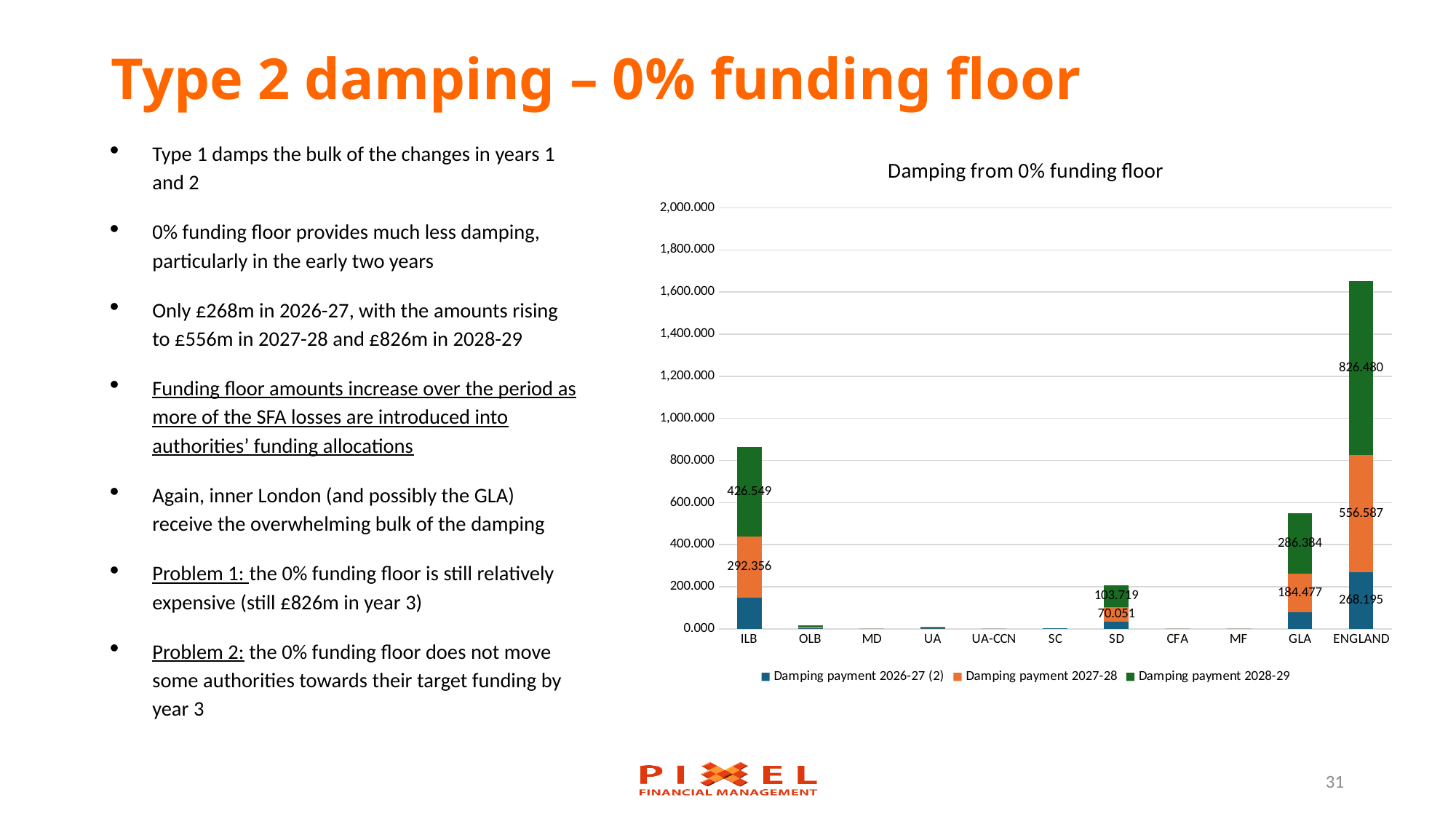
Is the total stacked bar for GLA greater or less than 600.000? less Which has the larger total stacked bar, ILB or GLA? ILB What is the Damping payment 2028-29 value for GLA? 286.384 Which category has the highest total stacked bar? ENGLAND What is the Damping payment 2026-27 (2) value for ENGLAND? 268.195 What is the Damping payment 2027-28 value for ILB? 292.356 How many series does the chart legend list? 3 What is the difference between the Damping payment 2028-29 and Damping payment 2027-28 values for ENGLAND? 269.893 How many categories are shown on the x axis of the chart? 11 What is the title of the chart? Damping from 0% funding floor What is the Damping payment 2028-29 value for ENGLAND? 826.480 What type of chart is shown on the slide? Stacked bar chart